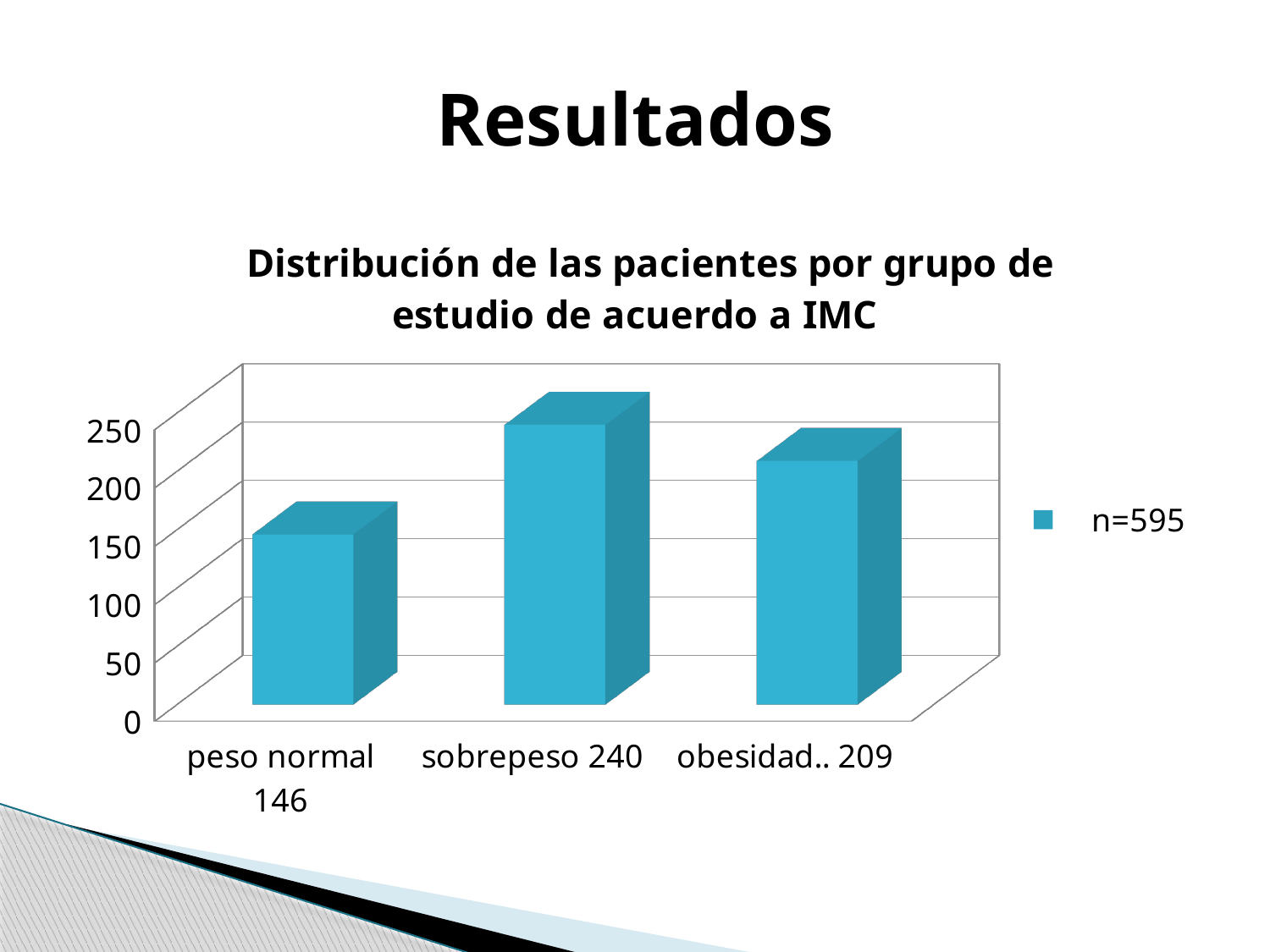
What is the number of patients in the 'peso normal' group? 146 What is the number of patients in the 'sobrepeso' group? 240 What is the difference between the 'sobrepeso' and 'peso normal' values? 94 What type of chart is shown on the slide? bar chart Which group has the highest number of patients? sobrepeso Which group has the lowest number of patients? peso normal Is the value for 'obesidad' greater or less than 200? greater What is the number of patients in the 'obesidad' group? 209 How many categories are shown on the x axis of the chart? 3 What is the title of the chart? Distribución de las pacientes por grupo de estudio de acuerdo a IMC How many series does the legend list? 1 What is the legend entry for the series in the chart? n=595